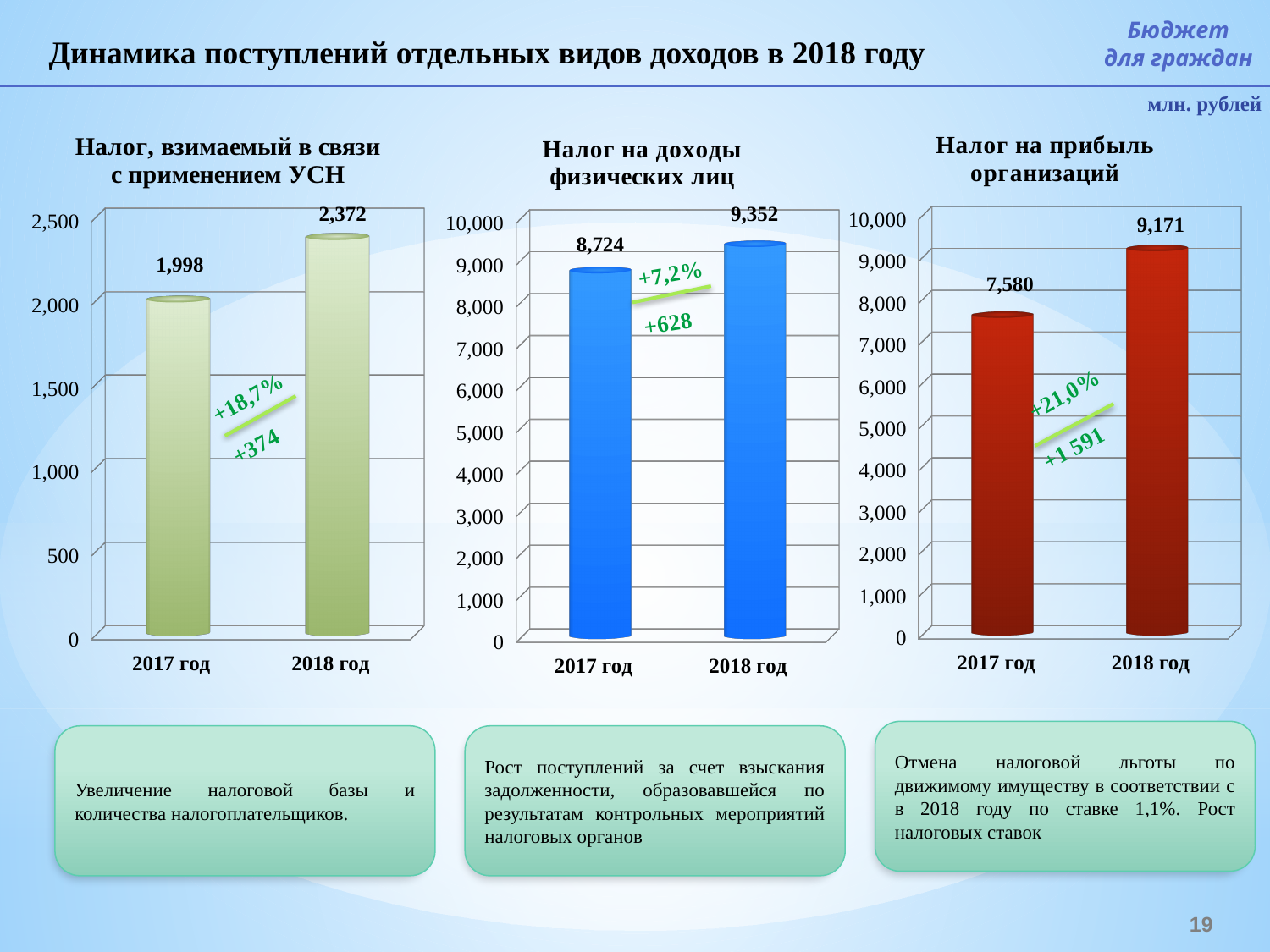
In the chart titled "Налог, взимаемый в связи с применением УСН", what is the value for 2017 год? 1,998 In the chart titled "Налог, взимаемый в связи с применением УСН", what is the value for 2018 год? 2,372 In the chart titled "Налог на доходы физических лиц", what is the value for 2018 год? 9,352 In the chart titled "Налог на доходы физических лиц", what is the value for 2017 год? 8,724 In the chart titled "Налог, взимаемый в связи с применением УСН", what is the difference between the 2018 год and 2017 год values? 374 How many categories are shown on the x axis of the chart titled "Налог, взимаемый в связи с применением УСН"? 2 In the chart titled "Налог на прибыль организаций", what is the difference between the 2018 год and 2017 год values? 1,591 In the chart titled "Налог на прибыль организаций", is the value for 2017 год greater or less than 8,000? less In the chart titled "Налог на прибыль организаций", what is the value for 2018 год? 9,171 What kind of chart is the chart titled "Налог на доходы физических лиц"? bar chart In the chart titled "Налог на прибыль организаций", what is the value for 2017 год? 7,580 In the chart titled "Налог на доходы физических лиц", which year has the higher value? 2018 год